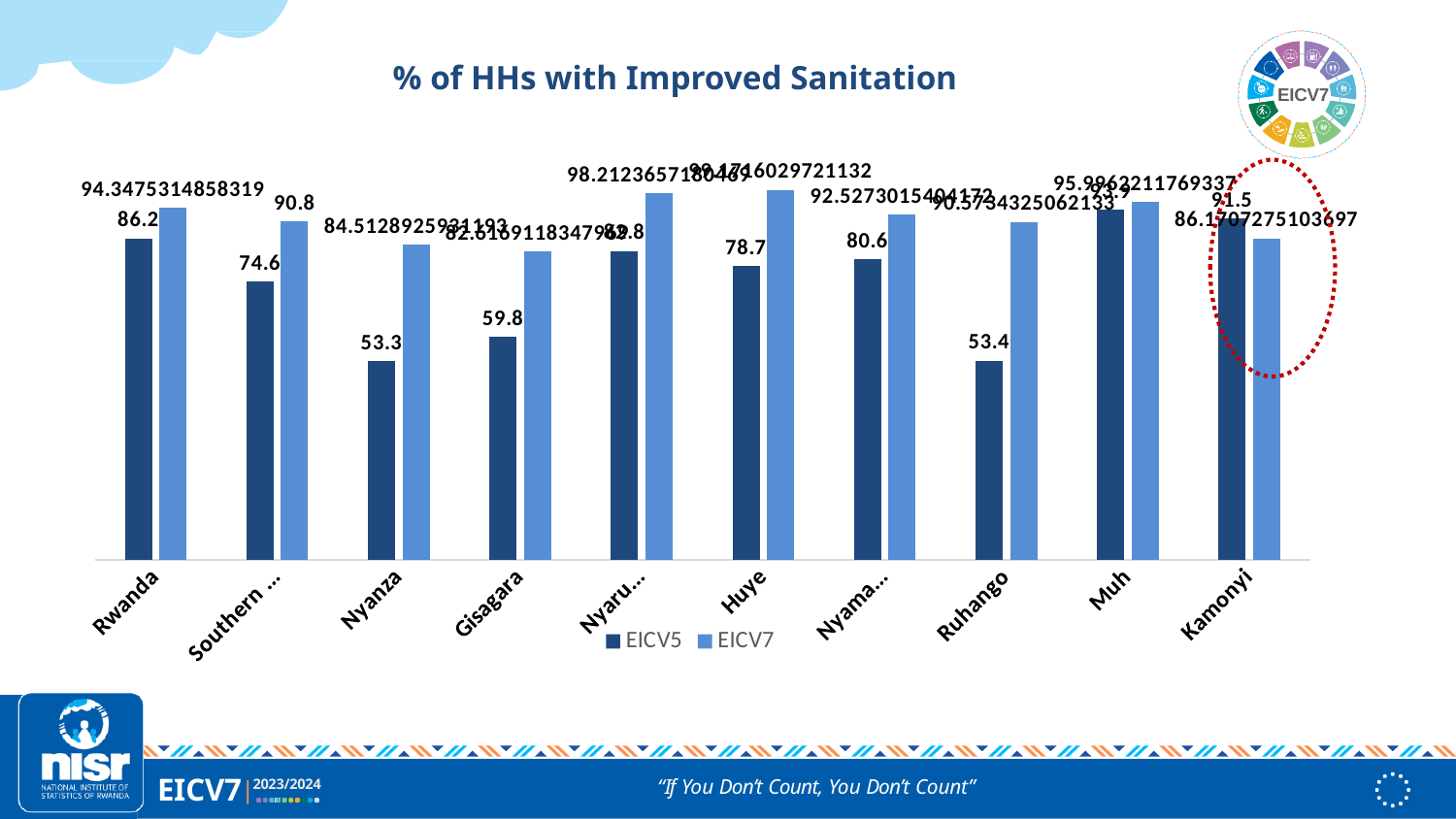
What is the EICV5 value for Rwanda? 86.2 What is the title of the chart? % of HHs with Improved Sanitation Which category is highlighted with a red dotted circle? Kamonyi How many series does the legend list? 2 What is the EICV5 value for Kamonyi? 91.5 What kind of chart is shown on the slide? bar chart For Kamonyi, which is larger, the EICV5 value or the EICV7 value? EICV5 What is the EICV5 value for Gisagara? 59.8 What is the EICV5 value for Ruhango? 53.4 What is the EICV7 value for Southern? 90.8 What is the difference between the EICV7 and EICV5 values for Southern? 16.2 How many categories are shown on the x axis? 10